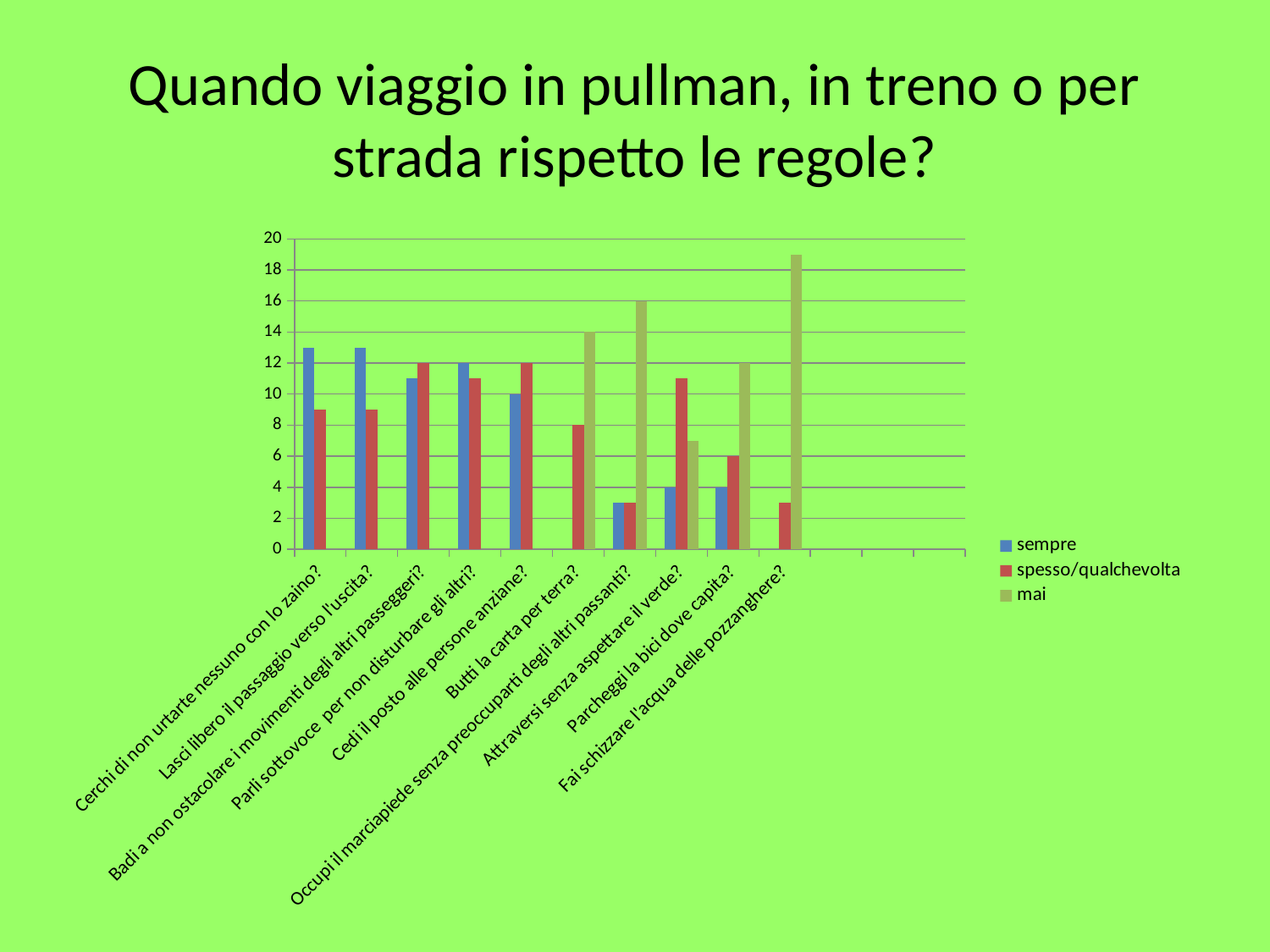
For 'Cerchi di non urtarte nessuno con lo zaino?', which is larger: 'sempre' or 'spesso/qualchevolta'? sempre How many categories are shown on the x axis? 10 For 'Occupi il marciapiede senza preoccuparti degli altri passanti?', which is larger: 'mai' or 'sempre'? mai Is the 'mai' value for 'Fai schizzare l'acqua delle pozzanghere?' greater or less than 18? greater What is the 'mai' value for 'Occupi il marciapiede senza preoccuparti degli altri passanti?'? 16 How many series does the legend list? 3 Which category has the highest value for the 'mai' series? Fai schizzare l'acqua delle pozzanghere? What kind of chart is shown on the slide? bar chart What is the 'sempre' value for 'Cedi il posto alle persone anziane?'? 10 Which series is shown in red in the legend? spesso/qualchevolta Is the 'sempre' value for 'Cerchi di non urtarte nessuno con lo zaino?' greater or less than 12? greater Is the 'spesso/qualchevolta' value for 'Attraversi senza aspettare il verde?' greater or less than 10? greater